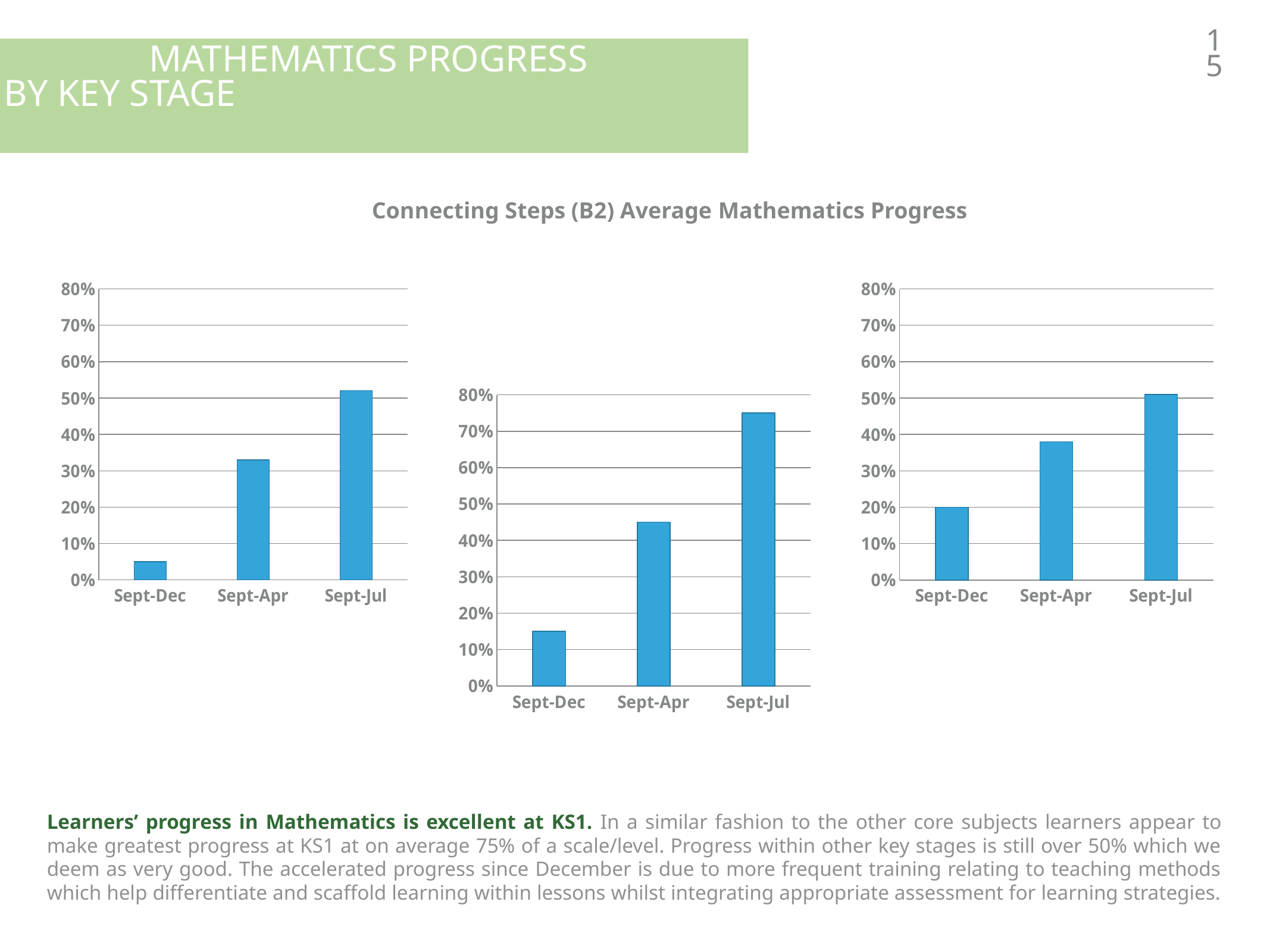
What kind of chart is the left chart on the slide? bar chart What is the overall title shown above the three charts? Connecting Steps (B2) Average Mathematics Progress In the left chart, which is larger, the value for Sept-Apr or the value for Sept-Jul? Sept-Jul In the right chart, is the value for Sept-Jul greater or less than 40%? greater In the middle chart, do the values rise or fall from Sept-Dec to Sept-Jul? rise In the middle chart, is the value for Sept-Jul greater or less than 70%? greater In the left chart, which period has the highest value? Sept-Jul In the left chart, is the value for Sept-Dec greater or less than 10%? less In the middle chart, which period has the lowest value? Sept-Dec In the right chart, what is the value for Sept-Dec? 20% How many categories are shown on the x axis of the middle chart? 3